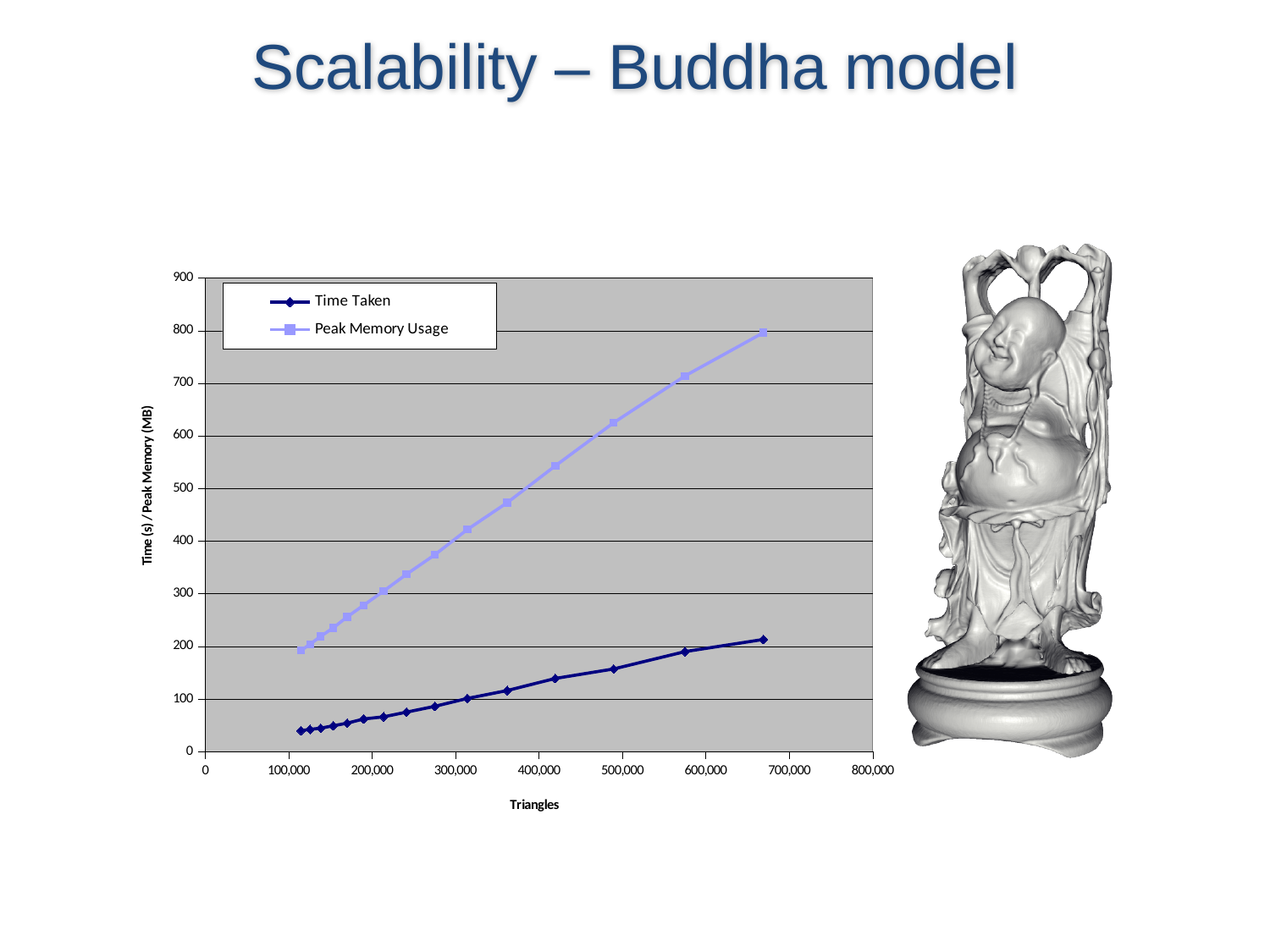
Which series has the higher values across the chart, Time Taken or Peak Memory Usage? Peak Memory Usage Does the Peak Memory Usage series rise or fall as the number of triangles increases? rise What kind of chart is shown on the slide? line chart Is the Time Taken value at the rightmost data point (around 670,000 triangles) greater or less than 200? greater Is the Peak Memory Usage value at around 575,000 triangles greater or less than 700? greater Is the Peak Memory Usage value at around 490,000 triangles greater or less than 600? greater Does the Time Taken series rise or fall as the number of triangles increases? rise What is the label of the chart's x axis? Triangles How many series does the chart's legend list? 2 What are the two series named in the chart's legend? Time Taken and Peak Memory Usage